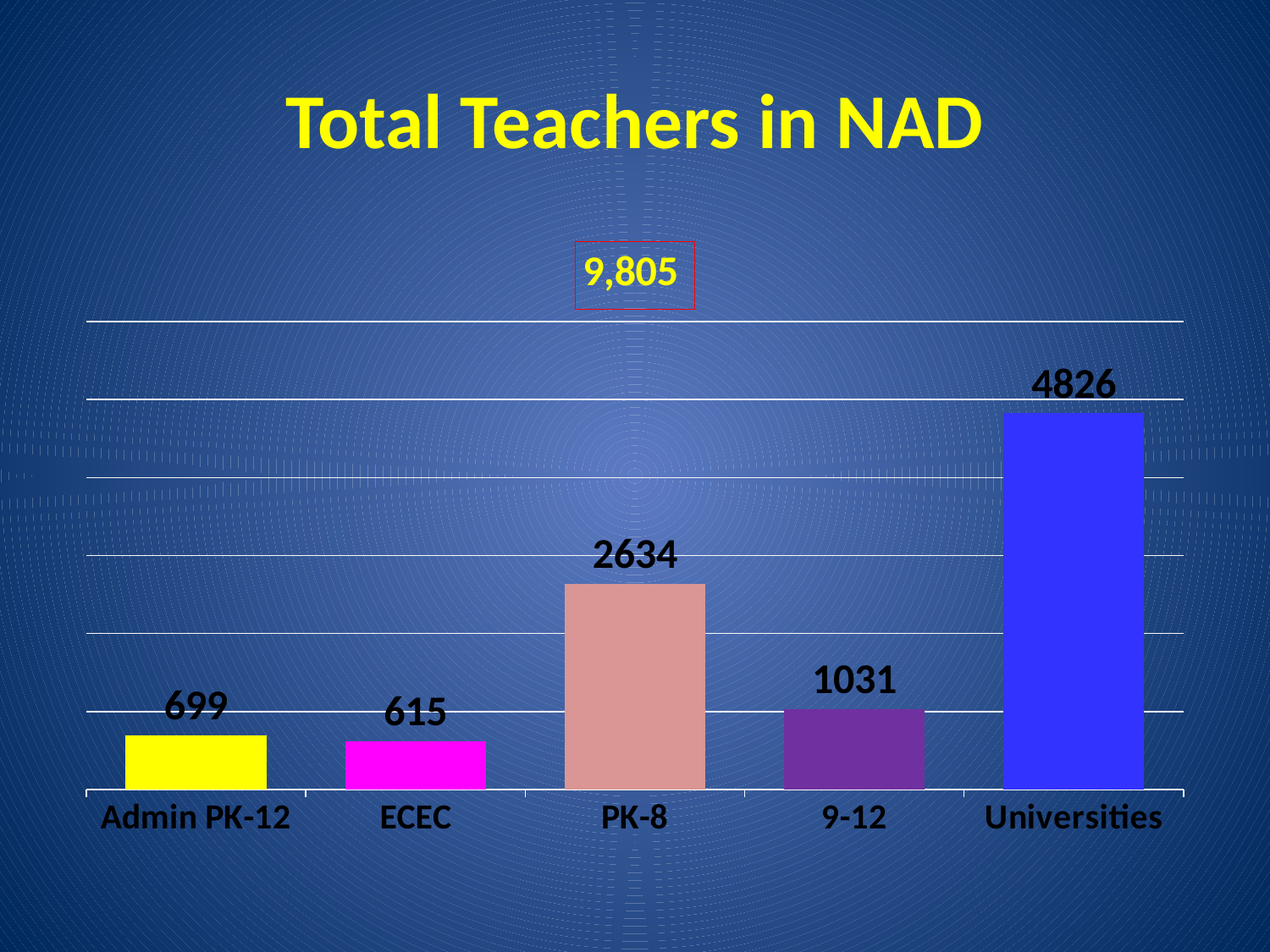
Which category has the lowest value? ECEC Which is larger, the value for 9-12 or the value for Admin PK-12? 9-12 What kind of chart is this? bar chart What is the difference between the values for Admin PK-12 and ECEC? 84 What is the value for PK-8? 2634 What is the title of the chart? Total Teachers in NAD What is the value for ECEC? 615 Which category has the highest value? Universities What is the difference between the values for Universities and PK-8? 2192 How many categories are shown on the x axis? 5 What is the value for 9-12? 1031 What is the value for Universities? 4826